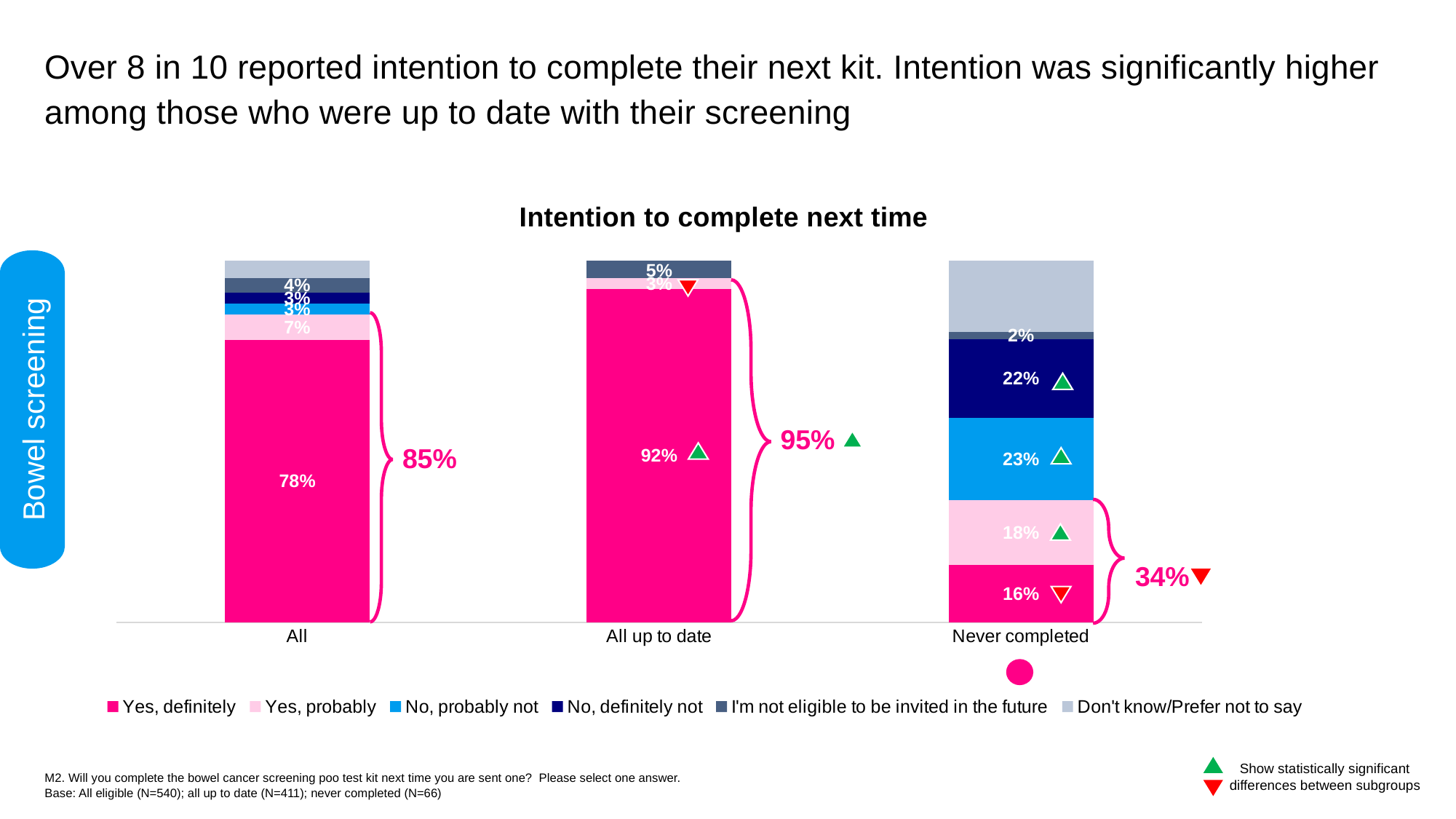
Which group has the highest 'Yes, definitely' percentage? All up to date What percentage of the 'All' group answered 'Yes, definitely'? 78% What percentage of the 'All up to date' group answered 'Yes, definitely'? 92% Which group has the lowest 'Yes, definitely' percentage? Never completed How many groups are shown on the x axis? 3 What is the combined 'Yes' percentage shown by the bracket for the 'Never completed' group? 34% What percentage of the 'All up to date' group said they are not eligible to be invited in the future? 5% What percentage of the 'Never completed' group answered 'No, probably not'? 23% Which is larger: the 'Yes, probably' share for 'Never completed' or for 'All'? Never completed How many series does the legend list? 6 How many percentage points higher is 'Yes, definitely' for 'All up to date' than for 'All'? 14 percentage points What is the difference between the bracketed totals for 'All up to date' and 'All'? 10 percentage points